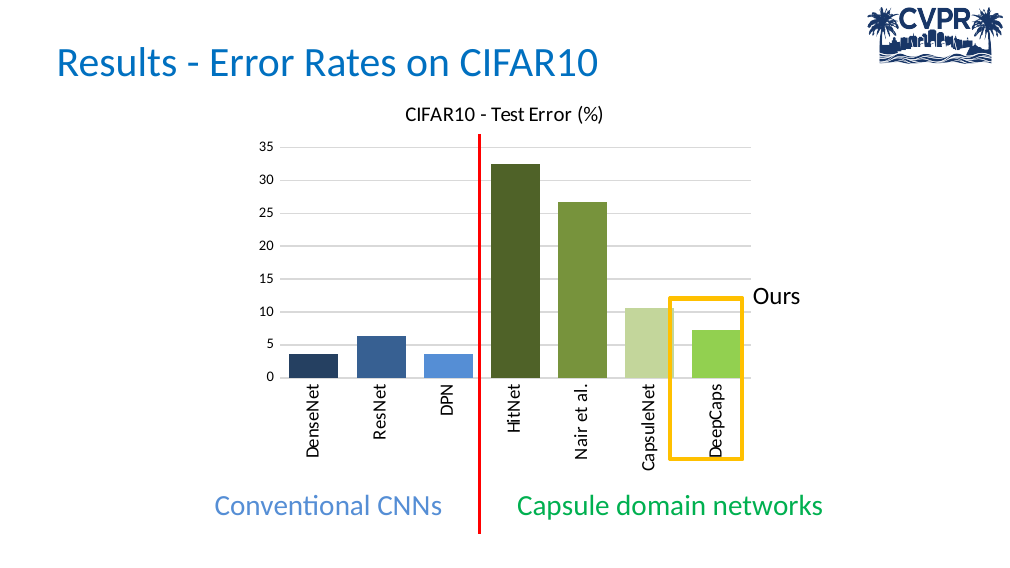
Which has a lower test error, CapsuleNet or DeepCaps? DeepCaps Is the test error for Nair et al. greater or less than 25? greater Which bar is highlighted with a yellow box and labelled "Ours"? DeepCaps Is the test error for DeepCaps greater or less than 10? less Is the test error for HitNet greater or less than 30? greater Which has a higher test error, HitNet or Nair et al.? HitNet What kind of chart is shown on the slide? bar chart How many networks (bars) are plotted in the chart? 7 Which network has the highest test error in the chart? HitNet What is the title of the chart? CIFAR10 - Test Error (%)